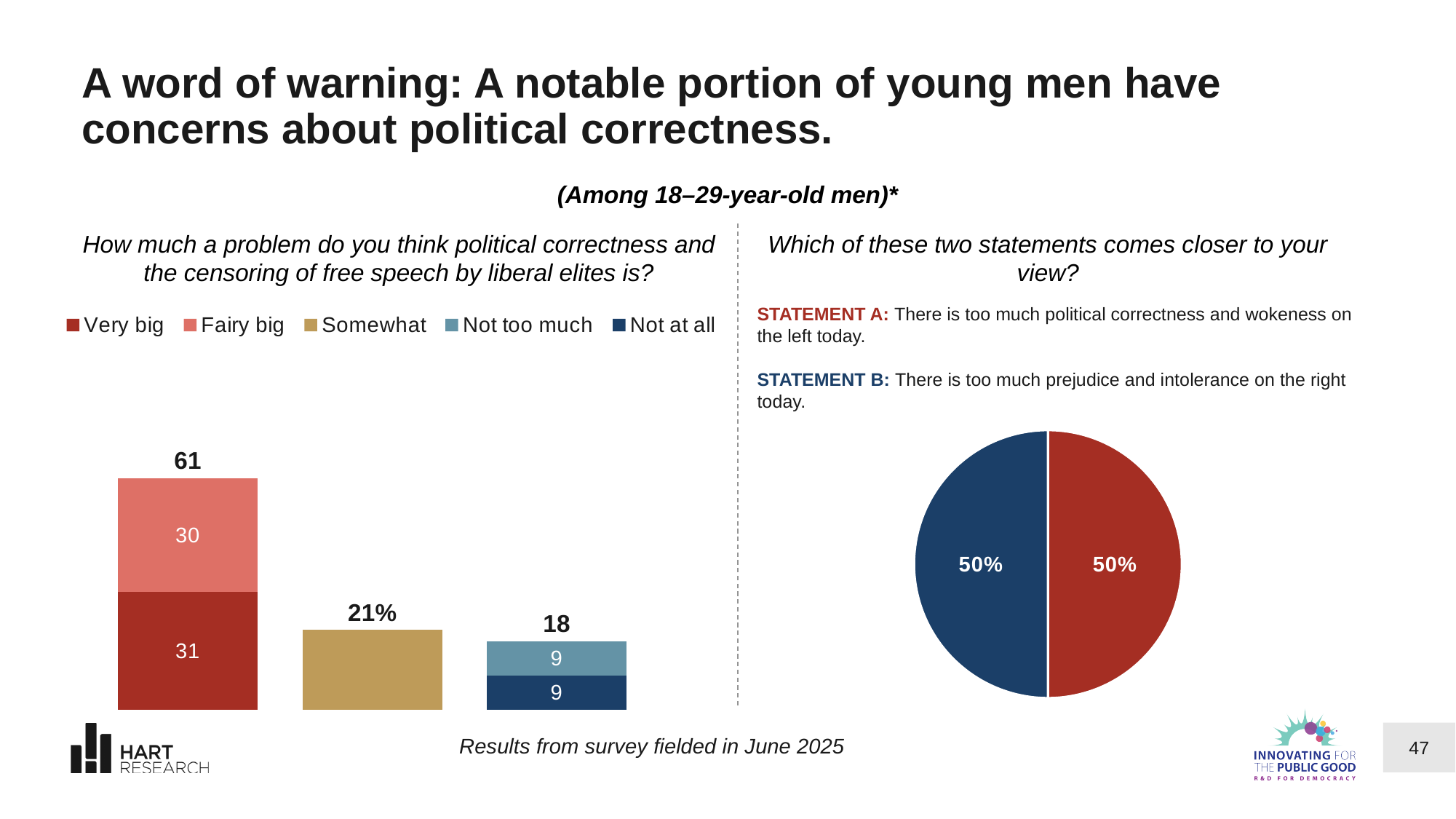
In the left chart on political correctness as a problem, what value is shown for the 'Somewhat' bar? 21% How many entries does the legend of the left chart on political correctness as a problem list? 5 In the left chart on political correctness as a problem, what is the total of the stacked bar combining 'Very big' and 'Fairy big'? 61 In the left chart on political correctness as a problem, what is the difference between the 'Very big' segment and the 'Not too much' segment? 22 What kind of chart is the left chart on political correctness as a problem? Stacked bar chart In the right pie chart on which statement comes closer to your view, what share is shown for the red slice? 50% In the left chart on political correctness as a problem, what is the total of the stacked bar combining 'Not too much' and 'Not at all'? 18 In the left chart on political correctness as a problem, what value is shown for the 'Not at all' segment? 9 How many slices does the right pie chart on which statement comes closer to your view have? 2 In the left chart on political correctness as a problem, what value is shown for the 'Very big' segment? 31 In the left chart on political correctness as a problem, which is larger: the 'Somewhat' bar or the combined 'Not too much'/'Not at all' bar? Somewhat In the left chart on political correctness as a problem, what value is shown for the 'Fairy big' segment? 30